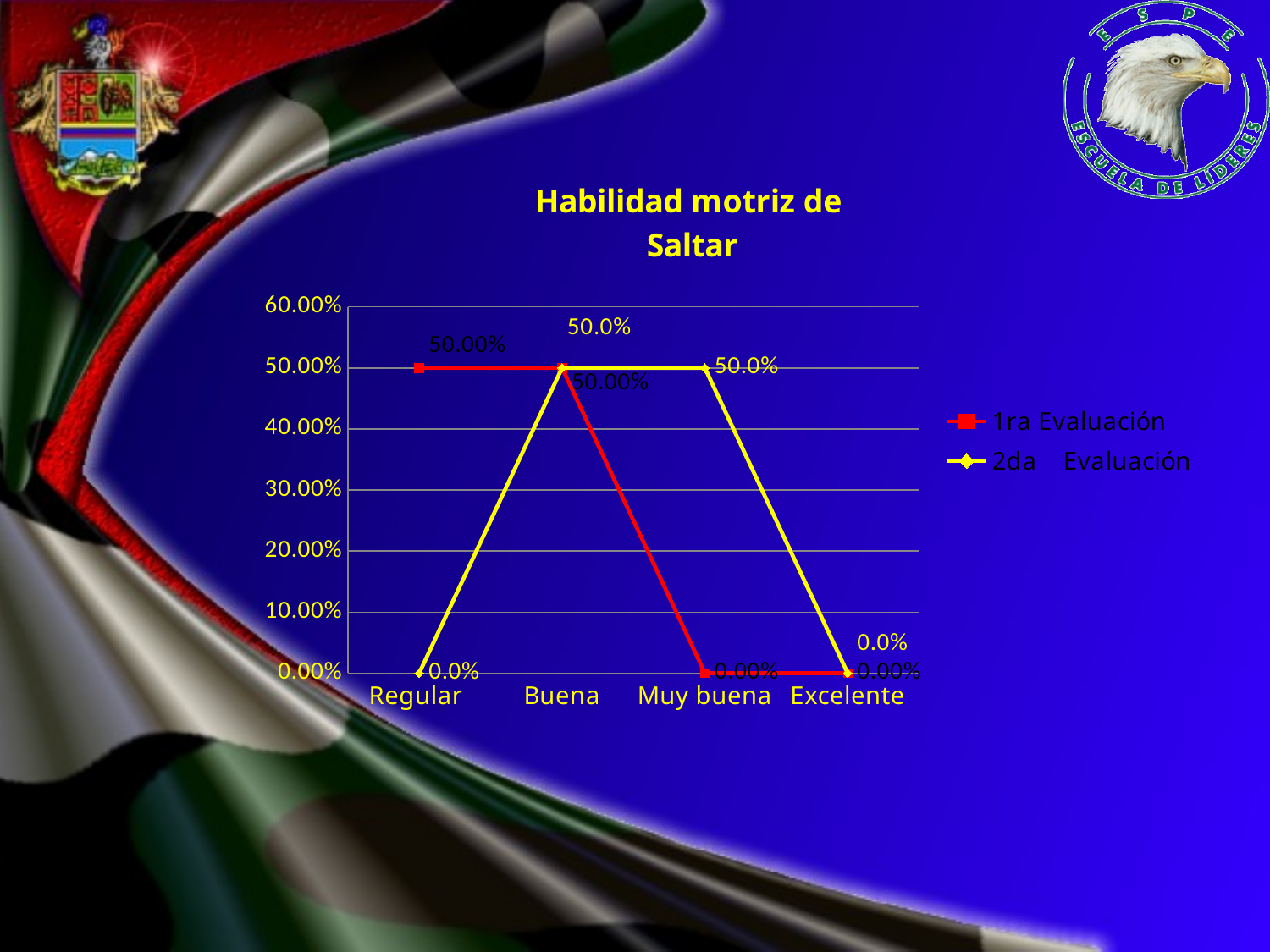
What is the value for Muy buena in the 1ra Evaluación series? 0.00% What is the difference between the 2da Evaluación and 1ra Evaluación values for Muy buena? 50.0% What is the title of the chart? Habilidad motriz de Saltar How many categories are shown on the x axis? 4 Which series has the larger value for Regular, 1ra Evaluación or 2da Evaluación? 1ra Evaluación How many series does the legend list? 2 What kind of chart is shown on the slide? line chart What is the value for Regular in the 2da Evaluación series? 0.0% What is the value for Muy buena in the 2da Evaluación series? 50.0% What is the value for Regular in the 1ra Evaluación series? 50.00% Which colour is used for the 2da Evaluación line? yellow What is the value for Excelente in the 2da Evaluación series? 0.0%